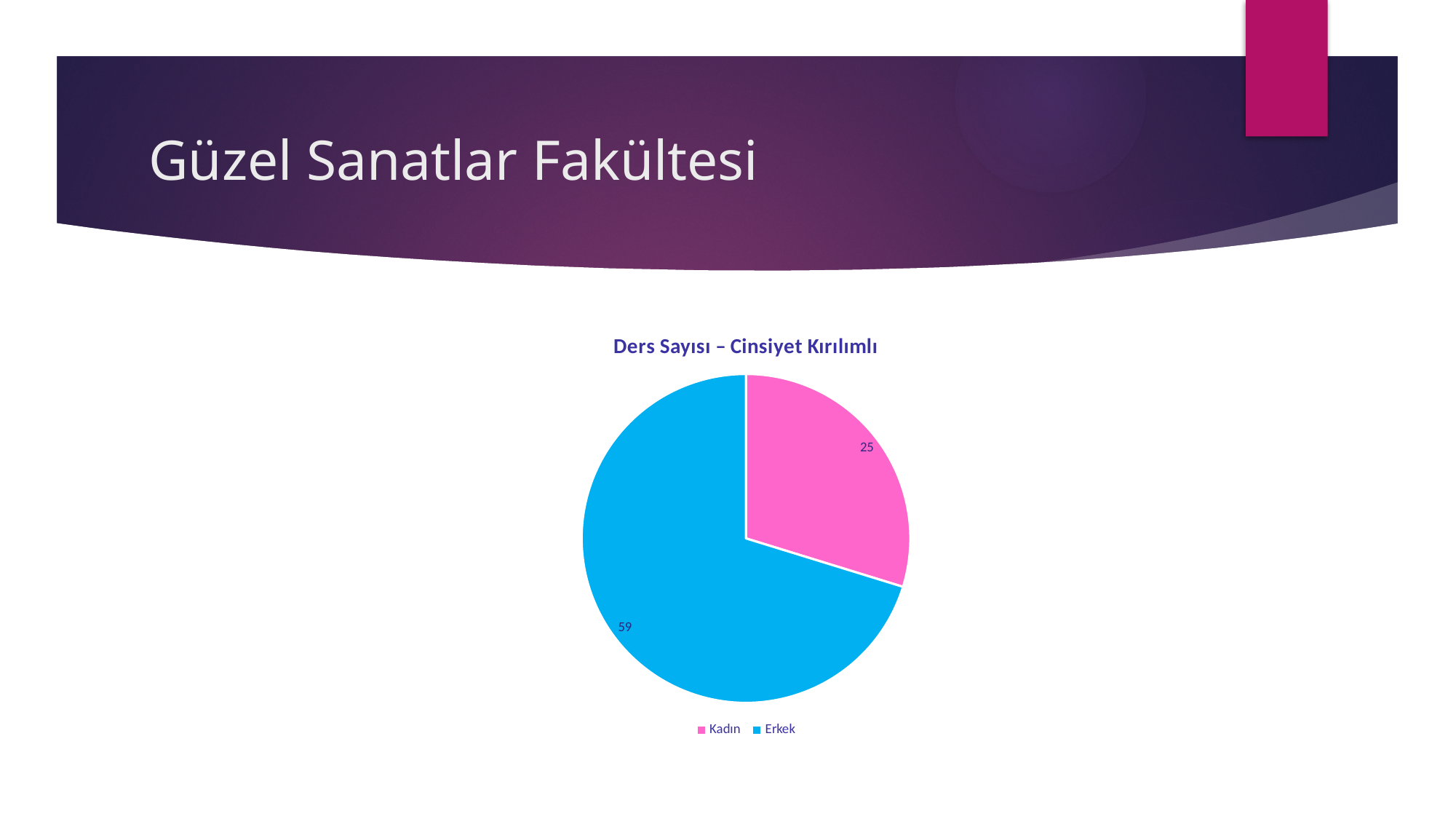
How many categories does the pie chart show? 2 Which category has the smallest slice in the pie chart? Kadın What is the value for Erkek in the pie chart? 59 How many entries does the legend list? 2 Which is larger, the value for Kadın or the value for Erkek? Erkek What colour is the Erkek slice in the pie chart? blue What is the total of all slices in the pie chart? 84 What is the difference between the Erkek and Kadın values? 34 What type of chart is shown on the slide? pie chart Which category has the largest slice in the pie chart? Erkek What is the value for Kadın in the pie chart? 25 What is the title of the chart? Ders Sayısı – Cinsiyet Kırılımlı